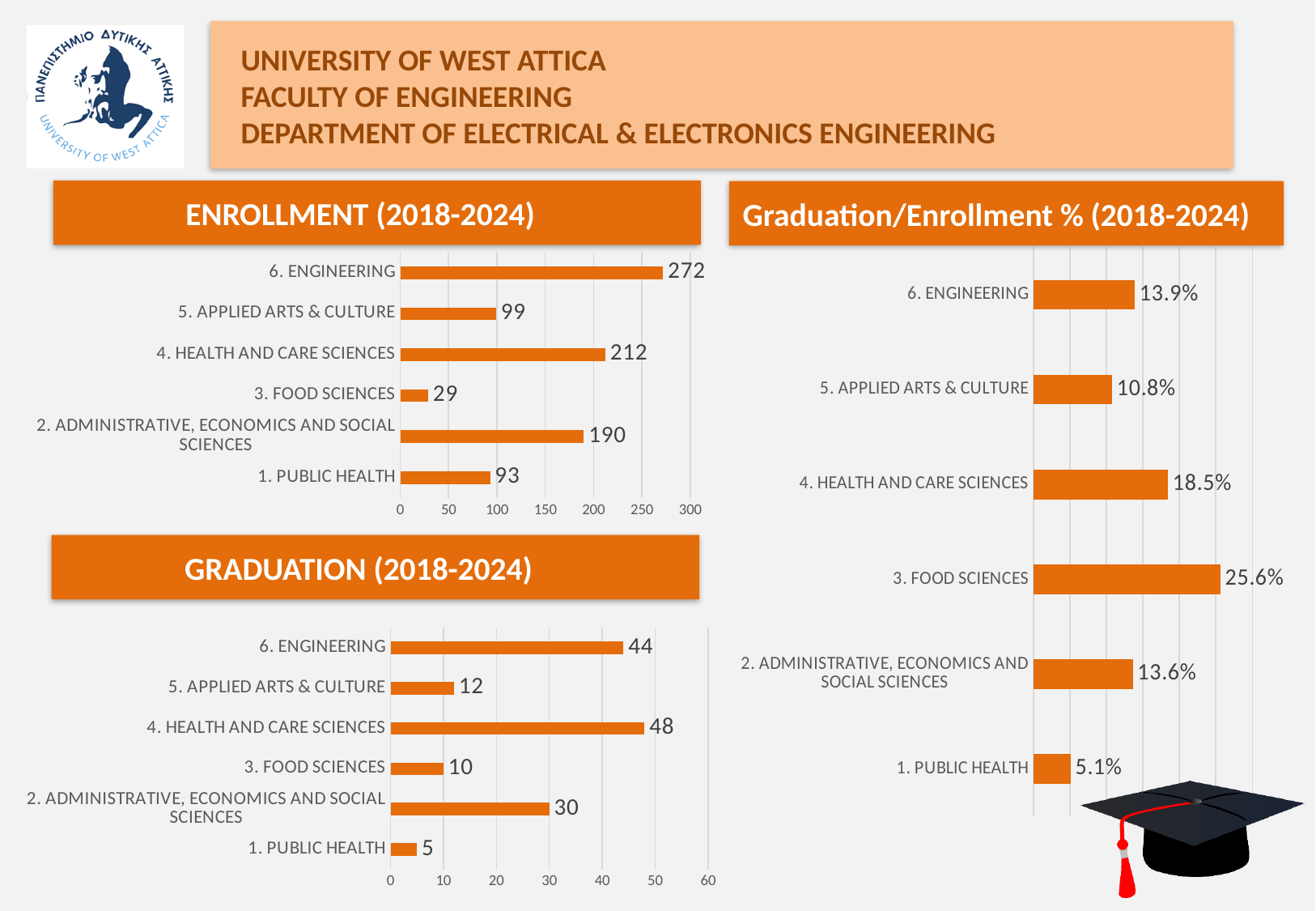
In the ENROLLMENT (2018-2024) chart, what is the difference between 4. HEALTH AND CARE SCIENCES and 2. ADMINISTRATIVE, ECONOMICS AND SOCIAL SCIENCES? 22 In the Graduation/Enrollment % (2018-2024) chart, what is the difference between 4. HEALTH AND CARE SCIENCES and 6. ENGINEERING? 4.6% In the GRADUATION (2018-2024) chart, which is larger: 5. APPLIED ARTS & CULTURE or 3. FOOD SCIENCES? 5. APPLIED ARTS & CULTURE In the ENROLLMENT (2018-2024) chart, which category has the lowest value? 3. FOOD SCIENCES What kind of chart is the ENROLLMENT (2018-2024) chart? bar chart In the GRADUATION (2018-2024) chart, how many categories are shown? 6 In the Graduation/Enrollment % (2018-2024) chart, what is the value for 3. FOOD SCIENCES? 25.6% In the ENROLLMENT (2018-2024) chart, what is the value for 6. ENGINEERING? 272 In the GRADUATION (2018-2024) chart, which category has the highest value? 4. HEALTH AND CARE SCIENCES In the GRADUATION (2018-2024) chart, what is the value for 2. ADMINISTRATIVE, ECONOMICS AND SOCIAL SCIENCES? 30 In the ENROLLMENT (2018-2024) chart, is the value for 1. PUBLIC HEALTH greater or less than 100? less In the Graduation/Enrollment % (2018-2024) chart, which category has the lowest value? 1. PUBLIC HEALTH